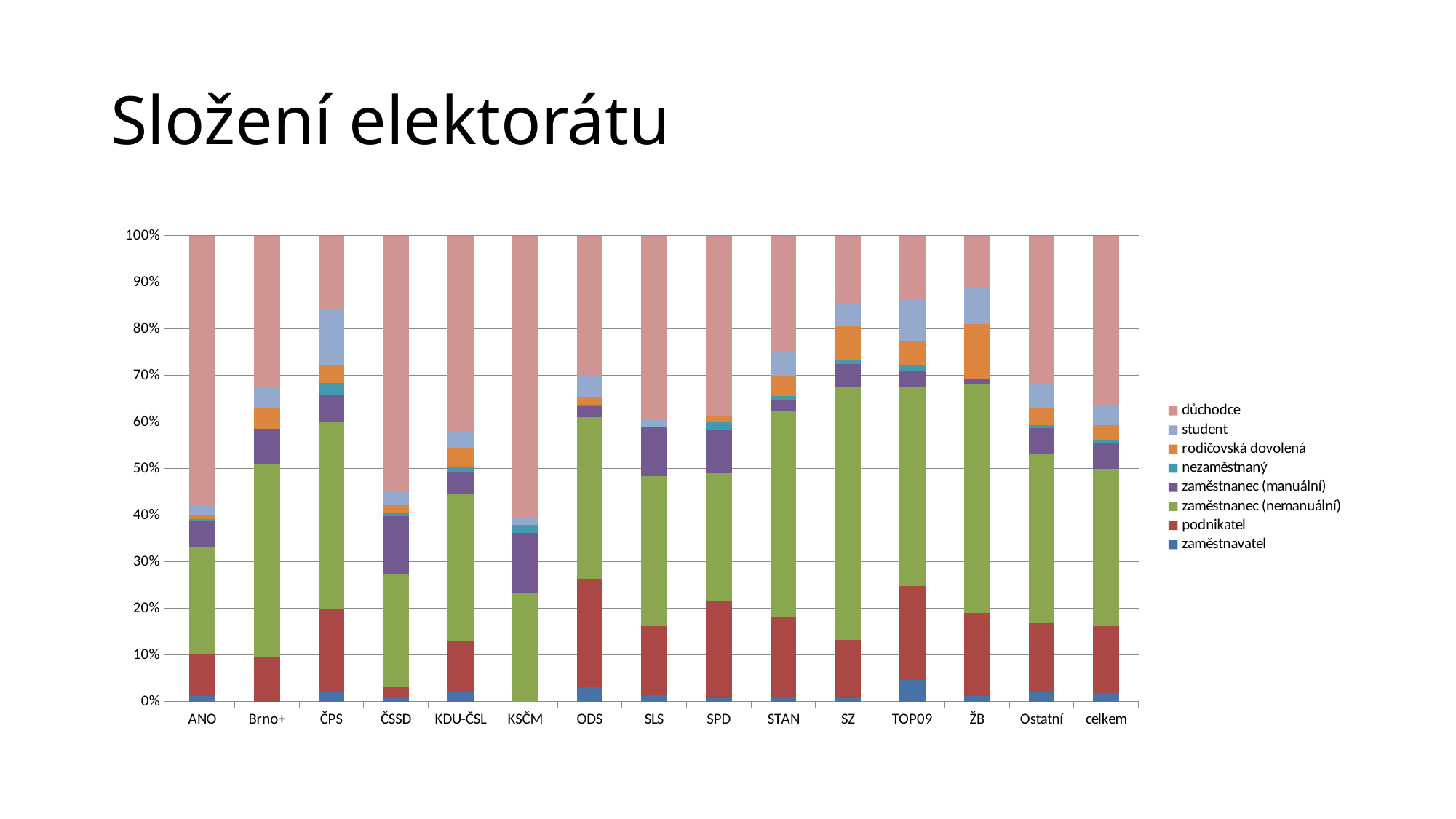
Is the důchodce share for KSČM larger or smaller than the důchodce share for ODS? larger What kind of chart is shown on the slide? Stacked bar chart How many categories are shown along the x axis of the chart? 15 Which category has the largest důchodce share in the chart? KSČM Which category has the largest zaměstnanec (nemanuální) segment in the chart? SZ Which legend entry is listed first (at the top) in the chart's legend? důchodce Which category has the largest student segment in the chart? ČPS Is the důchodce share for KSČM greater or less than 50%? greater What is the title of the slide containing the chart? Složení elektorátu How many series does the chart's legend list? 8